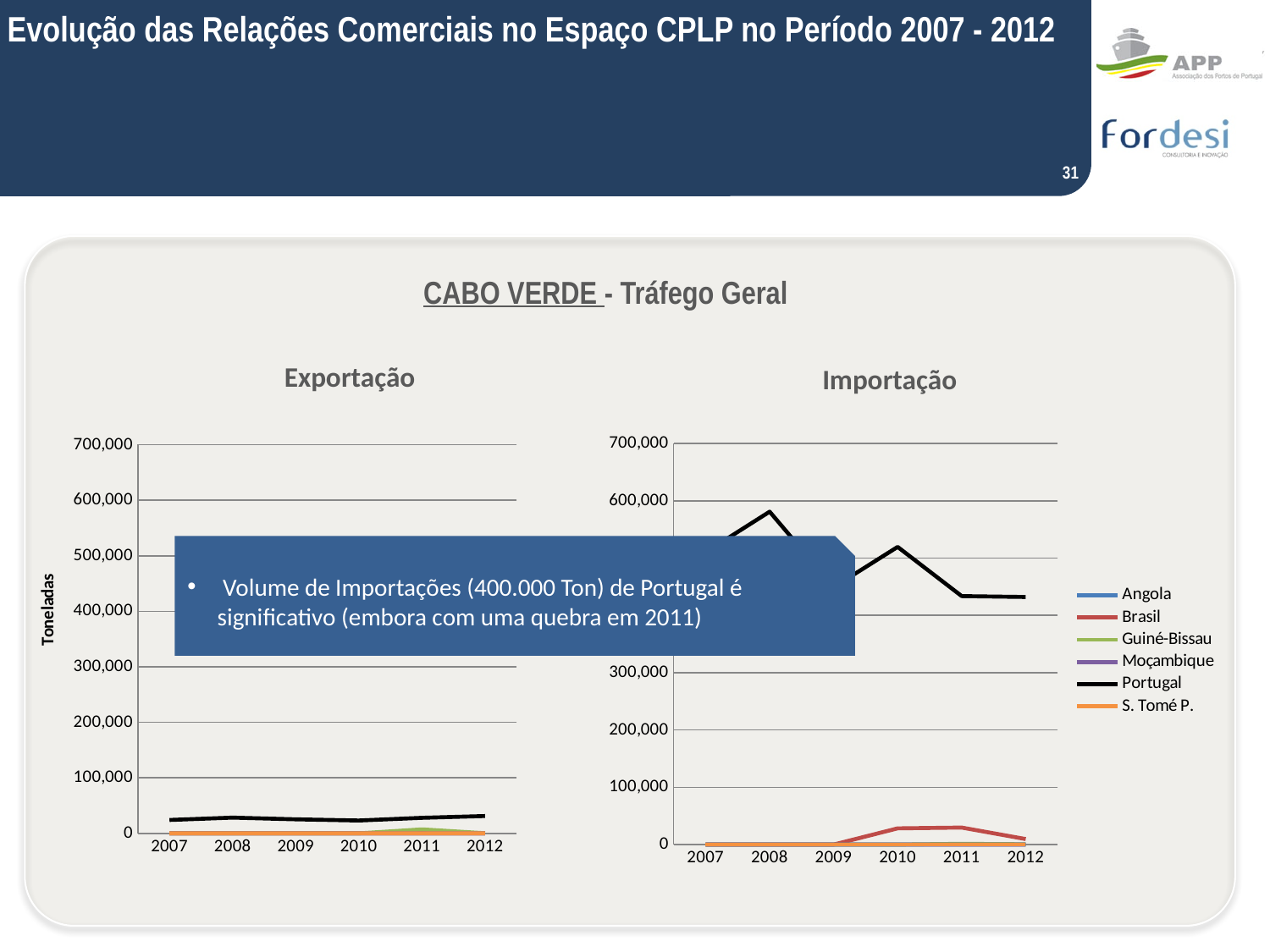
What kind of chart is the Importação chart? line chart In the Exportação chart, is the value for Portugal in 2012 greater or less than 100,000? less In the Importação chart, is the value for Portugal in 2008 greater or less than 500,000? greater In the Importação chart, which series has the highest values across the period? Portugal In the Importação chart, is the value for Portugal in 2012 greater or less than 500,000? less In the Exportação chart, which series has the highest values across the period? Portugal In the Importação chart, in which year does the Portugal line reach its highest value? 2008 In the Importação chart, which is larger for Portugal: the value in 2008 or the value in 2011? 2008 What is the label on the vertical axis of the Exportação chart? Toneladas In the Importação chart, does the Portugal line rise or fall from 2010 to 2011? fall How many series does the legend list? 6 How many years are plotted on the x axis of the Exportação chart? 6